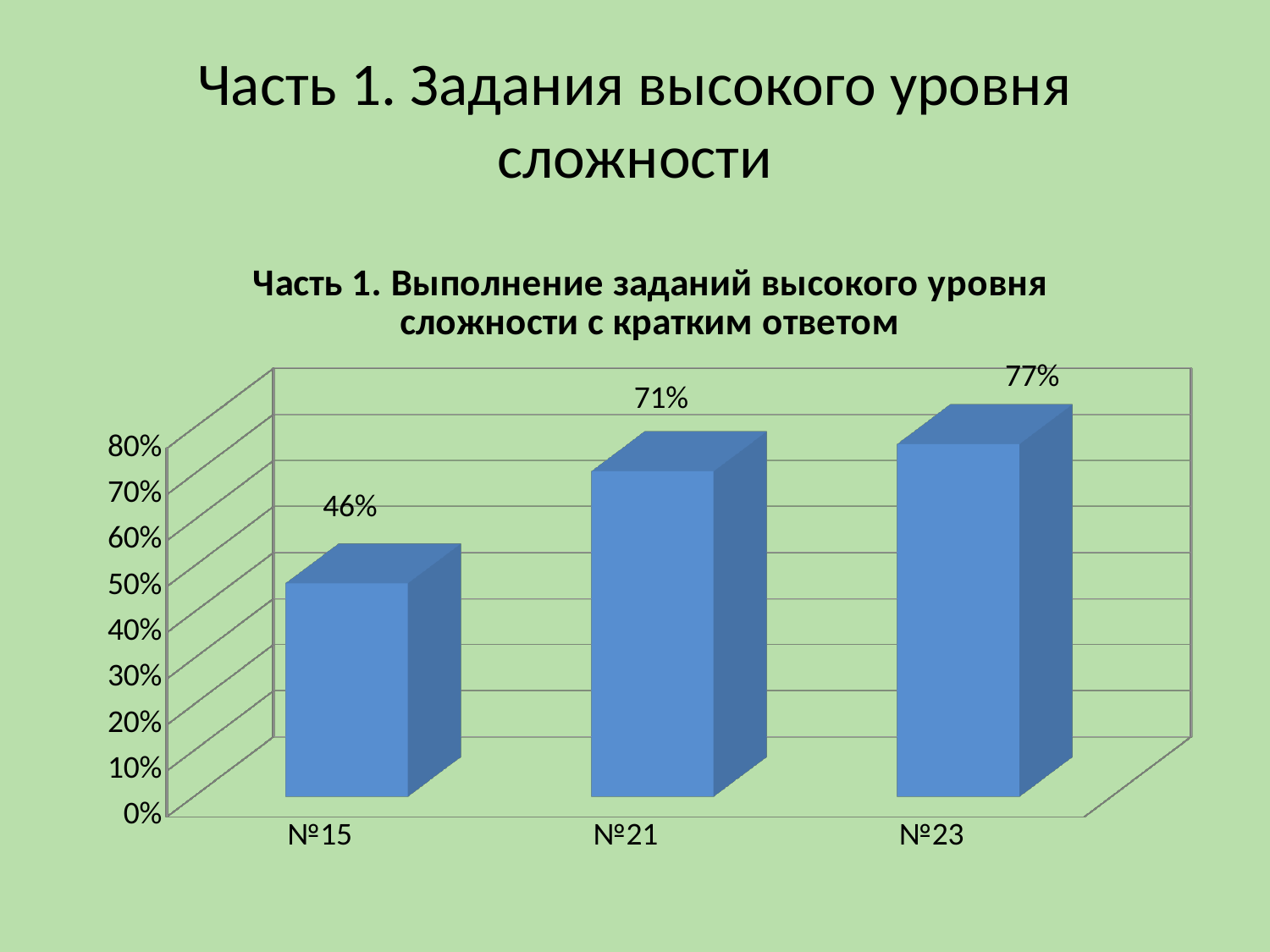
Which is larger, the value for №21 or the value for №15? №21 What is the value for №21? 71% Which category has the lowest value? №15 What is the difference between the values for №23 and №15? 31% Which category has the highest value? №23 What is the value for №15? 46% Is the value for №15 greater or less than 50%? less What is the difference between the values for №21 and №15? 25% What kind of chart is shown on the slide? bar chart How many categories are shown on the x axis? 3 Do the values rise or fall from №15 to №23 along the x axis? rise What is the value for №23? 77%